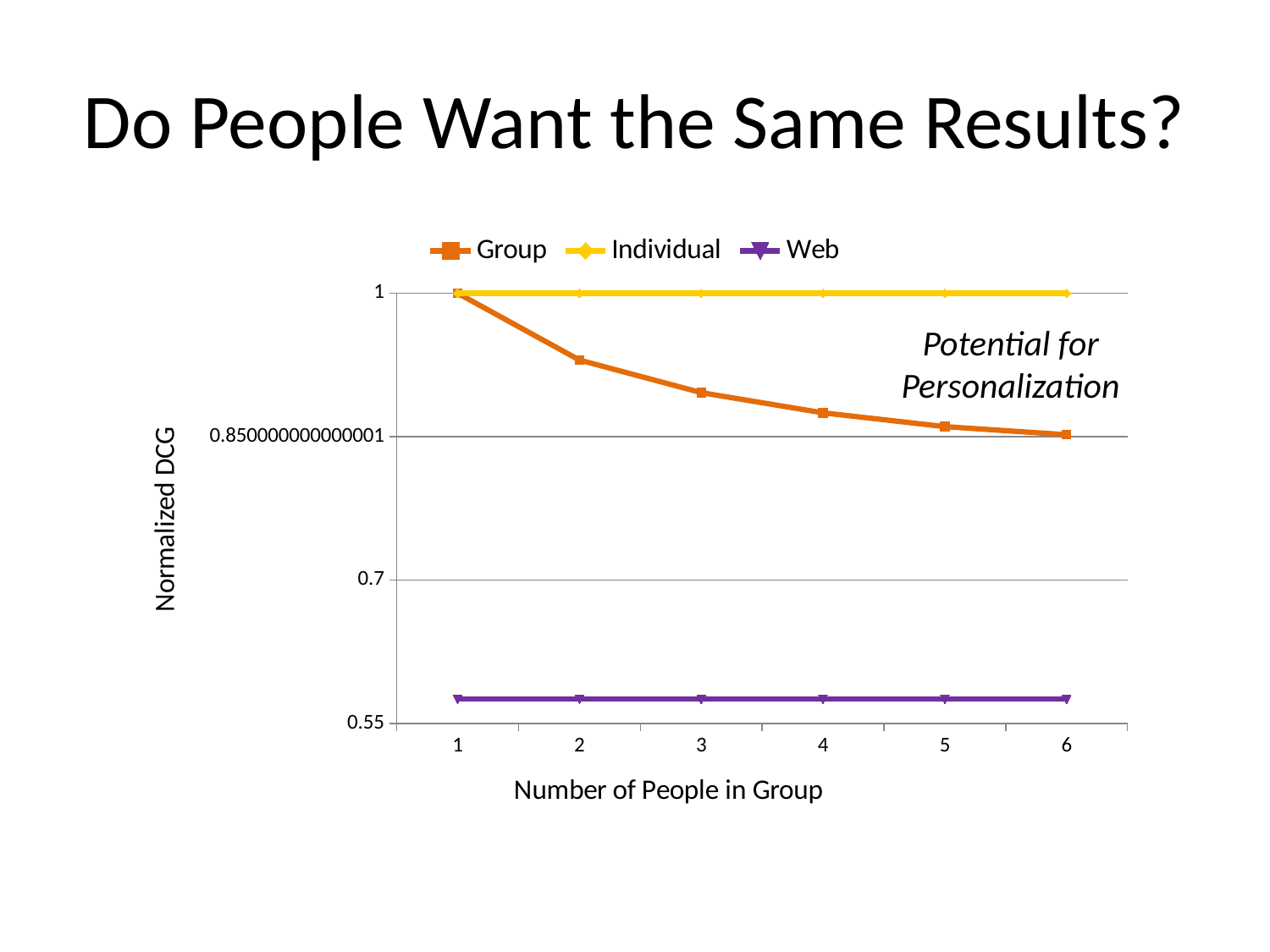
Is the Group value at 2 people in the group greater or less than 0.85? greater Does the Group series rise or fall as the number of people in the group increases from 1 to 6? fall At 3 people in the group, which is larger: the Group value or the Web value? Group Which series has the lowest Normalized DCG at 4 people in the group? Web What kind of chart is shown on the slide? line chart What is the title of the y axis? Normalized DCG How many points along the x axis (Number of People in Group) are plotted for each series? 6 What is the title of the x axis? Number of People in Group How many series does the legend list? 3 Is the Web value at 3 people in the group greater or less than 0.7? less Which series has the highest Normalized DCG at 6 people in the group? Individual What is the Normalized DCG value of the Individual series at 1 person in the group? 1